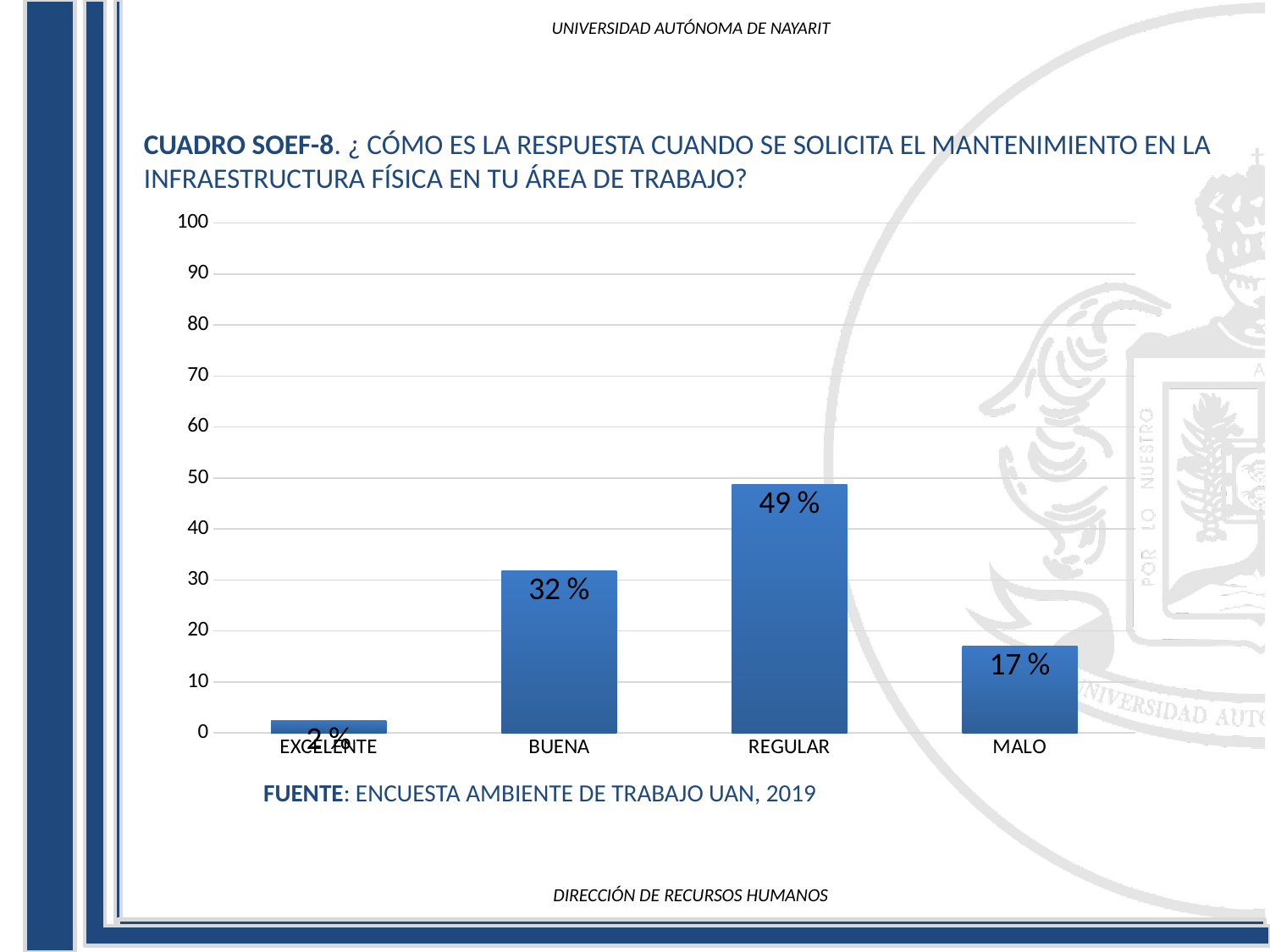
Is the value for REGULAR greater or less than 40? greater Which is larger, the value for BUENA or the value for MALO? BUENA What is the value for REGULAR? 49 % What kind of chart is shown on the slide? bar chart How many categories are shown on the x axis? 4 What is the difference between the values for REGULAR and BUENA? 17 % What source is cited below the chart? ENCUESTA AMBIENTE DE TRABAJO UAN, 2019 What is the value for MALO? 17 % What is the value for BUENA? 32 % Which category has the highest value? REGULAR Which category has the lowest value? EXCELENTE What is the difference between the values for BUENA and MALO? 15 %